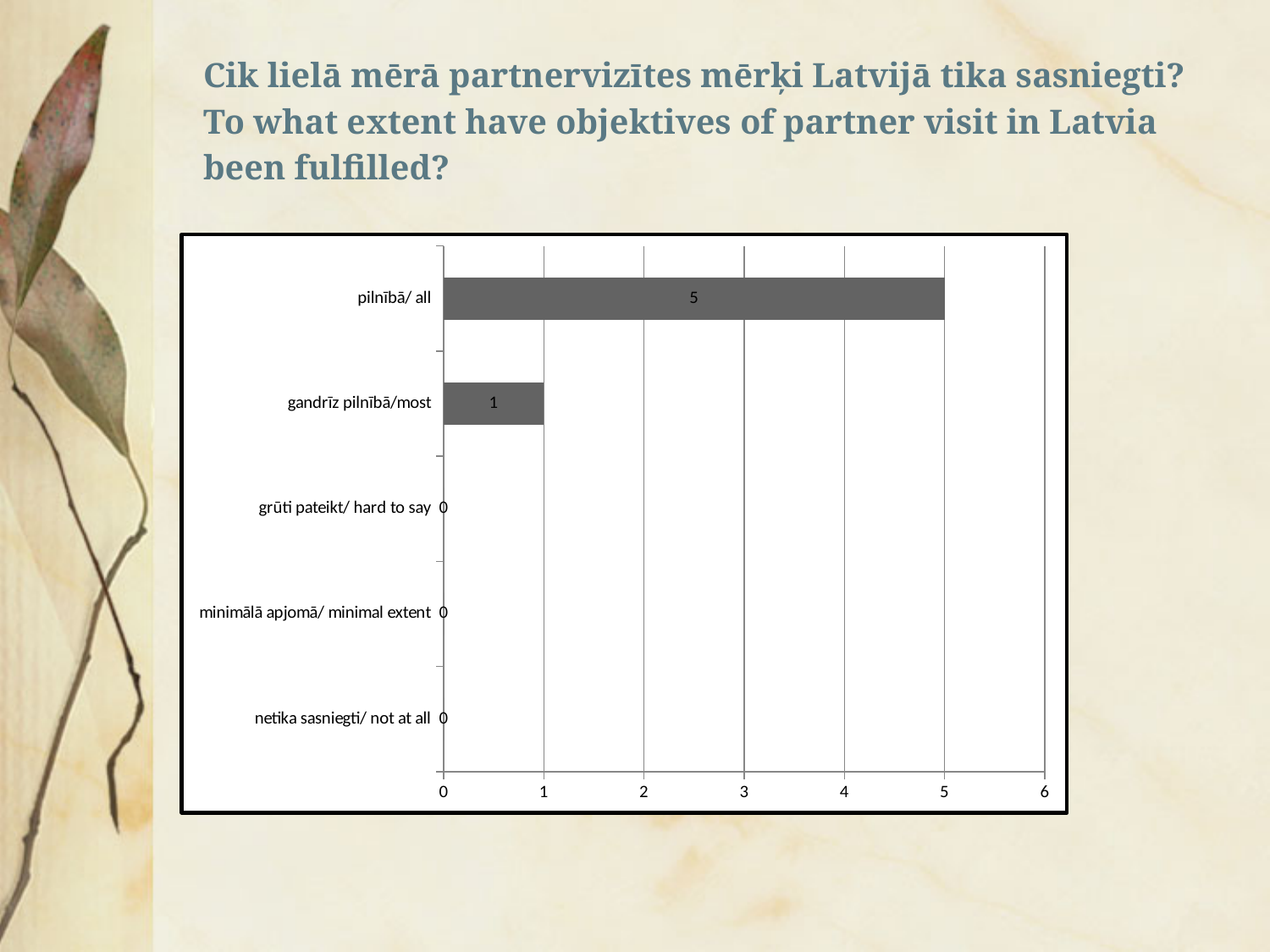
Which category has the highest value? pilnībā/ all How many categories are shown on the chart? 5 What is the difference between the values for "pilnībā/ all" and "gandrīz pilnībā/most"? 4 What is the value for "grūti pateikt/ hard to say"? 0 What is the value for "netika sasniegti/ not at all"? 0 What is the total of all the values shown on the chart? 6 What is the maximum value shown on the horizontal axis? 6 What kind of chart is shown on the slide? bar chart What is the value for "gandrīz pilnībā/most"? 1 Which is larger, the value for "pilnībā/ all" or the value for "gandrīz pilnībā/most"? pilnībā/ all What is the value for "pilnībā/ all"? 5 How many categories have a value of 0? 3